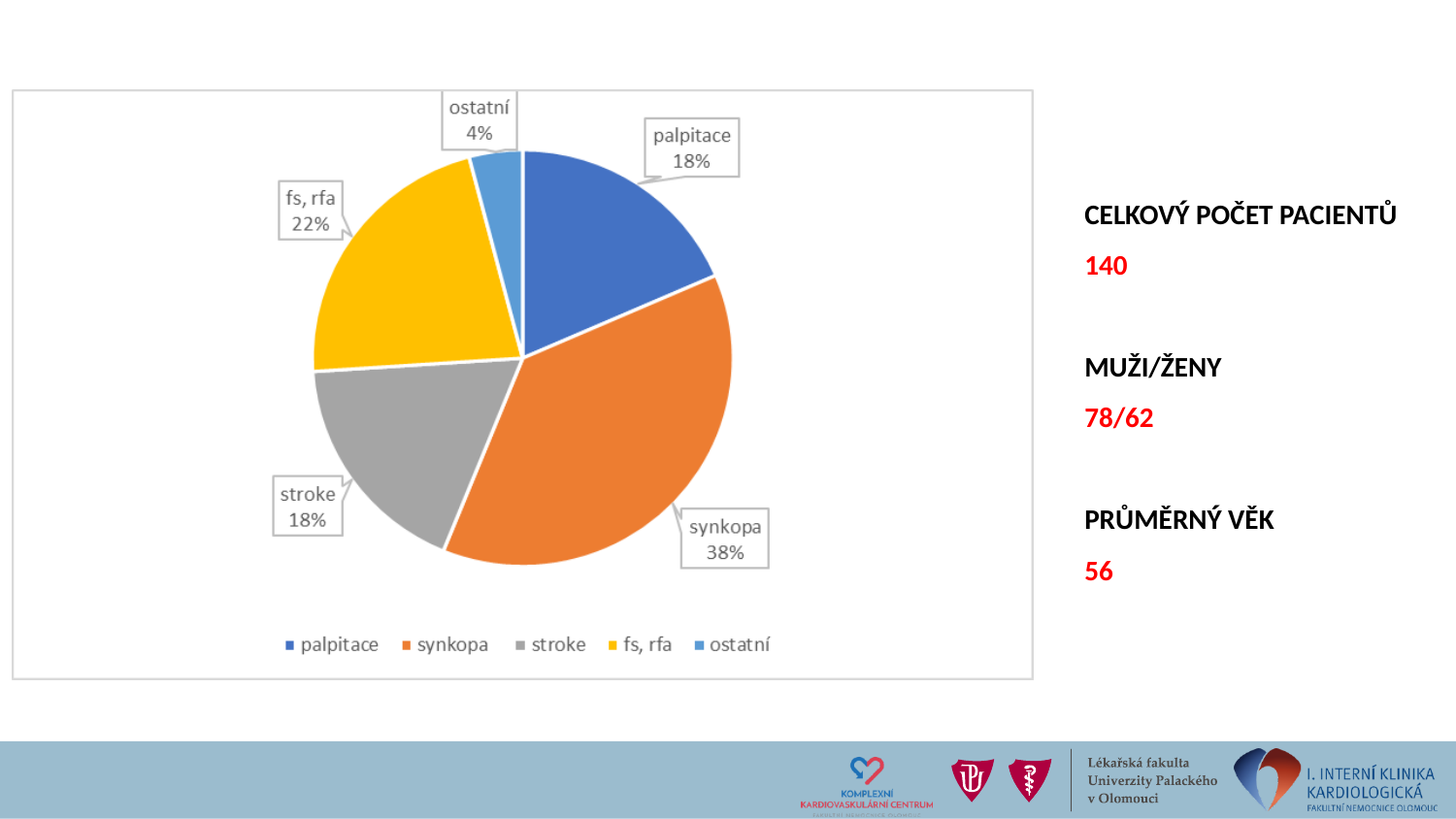
How many entries does the legend list? 5 What share of the pie does synkopa represent? 38% Which category has the smallest slice of the pie? ostatní What share of the pie does palpitace represent? 18% What is the difference in percentage points between synkopa and stroke? 20 Which category has the largest slice of the pie? synkopa What kind of chart is shown on the slide? pie chart Which is larger, the share for fs, rfa or the share for palpitace? fs, rfa What share of the pie does ostatní represent? 4% How many categories does the pie chart have? 5 What share of the pie does fs, rfa represent? 22% What colour is the synkopa slice? orange